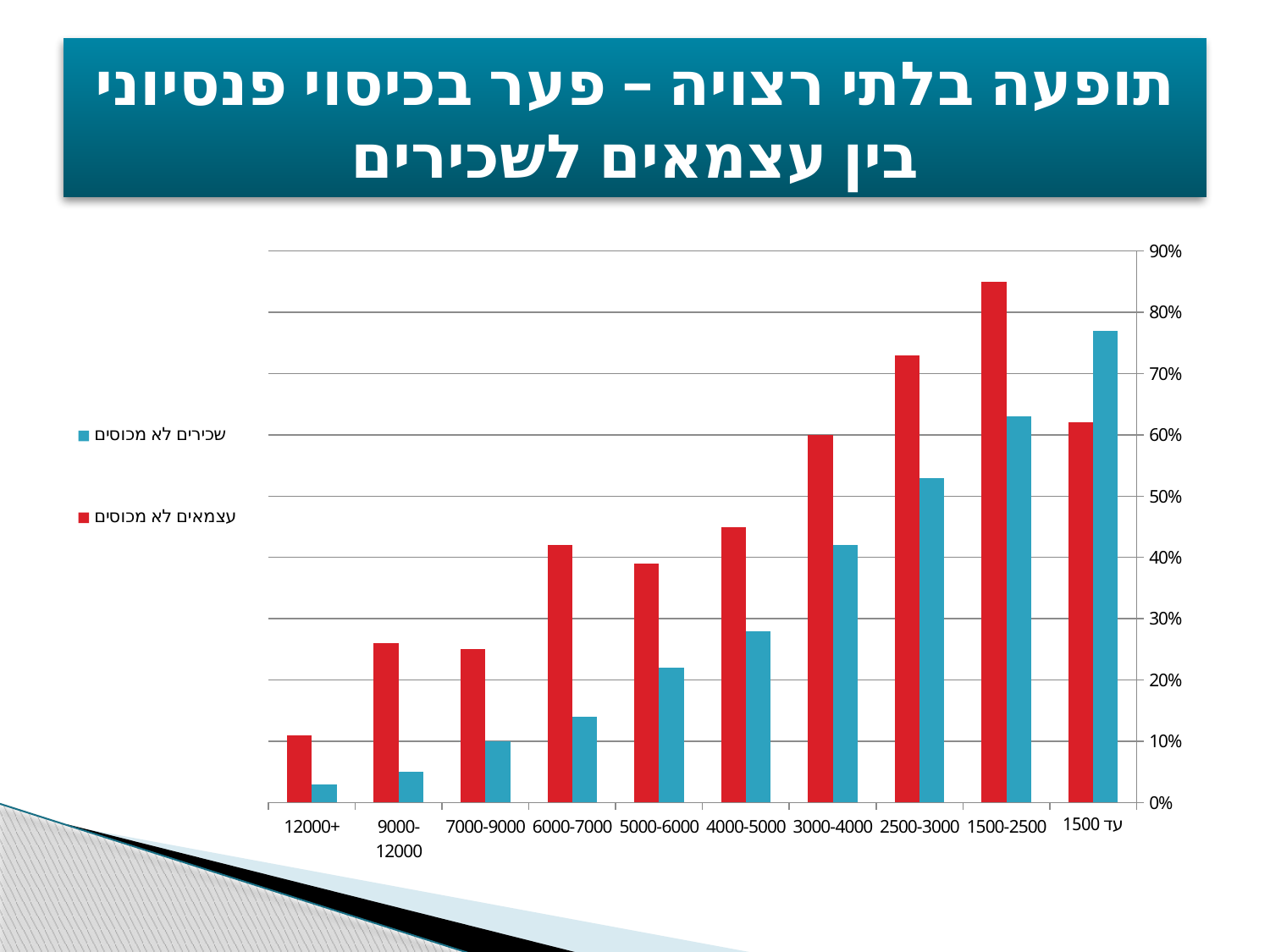
Which category has the highest value for שכירים לא מכוסים? עד 1500 How many income categories are shown on the x axis? 10 What kind of chart is shown on the slide? bar chart How many series does the legend list? 2 Which category has the lowest value for שכירים לא מכוסים? 12000+ Is the value for עצמאים לא מכוסים in the 1500-2500 category greater or less than 80%? greater Which category has the highest value for עצמאים לא מכוסים? 1500-2500 Which colour represents עצמאים לא מכוסים in the chart? red In the עד 1500 category, which series has the larger value, עצמאים לא מכוסים or שכירים לא מכוסים? שכירים לא מכוסים In the 1500-2500 category, which series has the larger value, עצמאים לא מכוסים or שכירים לא מכוסים? עצמאים לא מכוסים Which category has the lowest value for עצמאים לא מכוסים? 12000+ Is the value for שכירים לא מכוסים in the 12000+ category greater or less than 10%? less